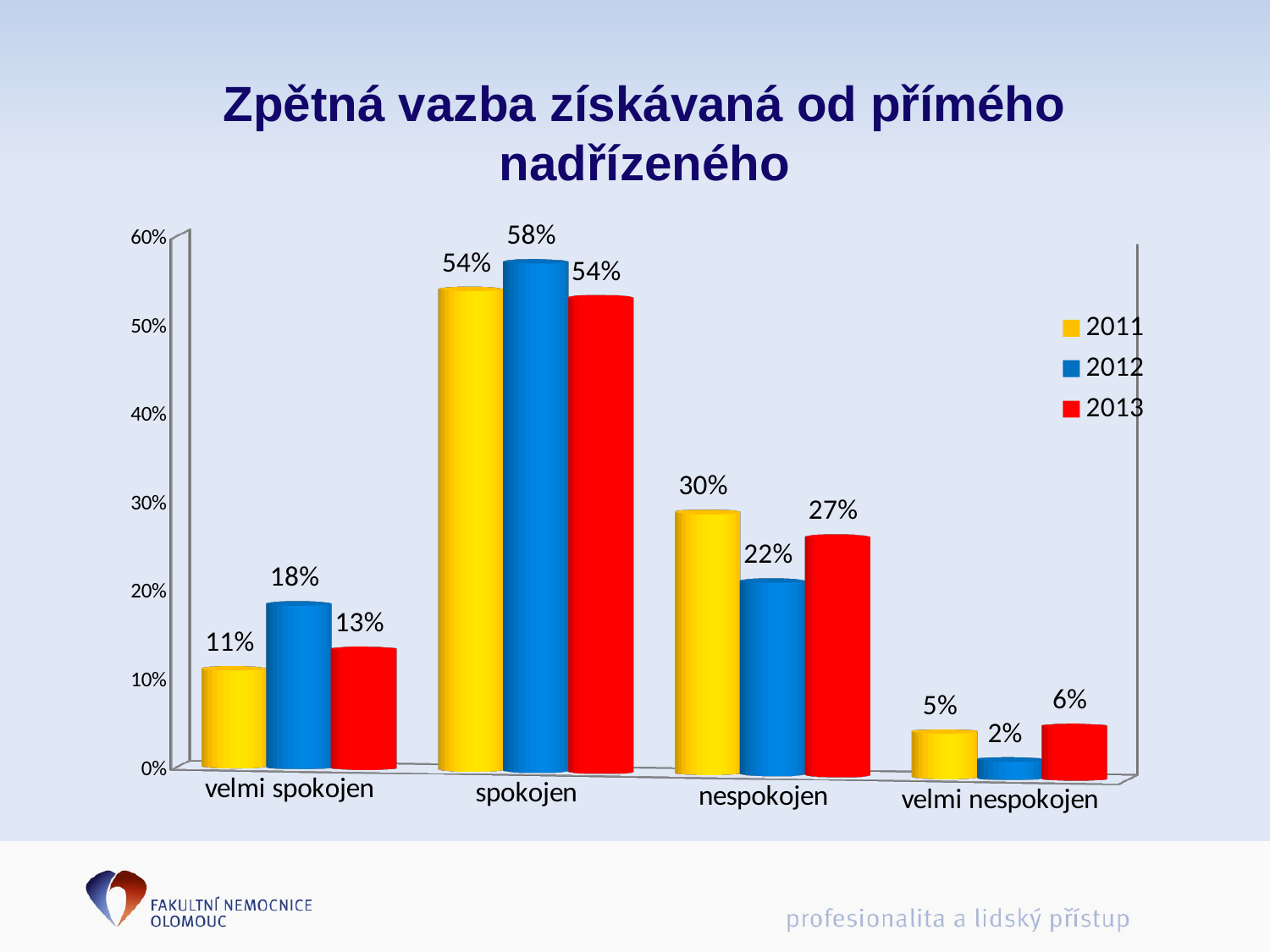
How many series does the legend list? 3 What is the difference between the 2011 and 2013 values for 'nespokojen'? 3% Which category has the highest value in 2013? spokojen What is the difference between the 2011 and 2012 values for 'velmi spokojen'? 7% Which is larger for 'nespokojen': the 2012 value or the 2013 value? 2013 Which colour represents the 2013 series in the legend? red What kind of chart is shown on the slide? bar chart What is the value for 'velmi nespokojen' in 2013? 6% What is the value for 'nespokojen' in 2011? 30% What is the value for 'spokojen' in 2012? 58% Which category has the lowest value in 2012? velmi nespokojen How many categories are shown on the x axis? 4